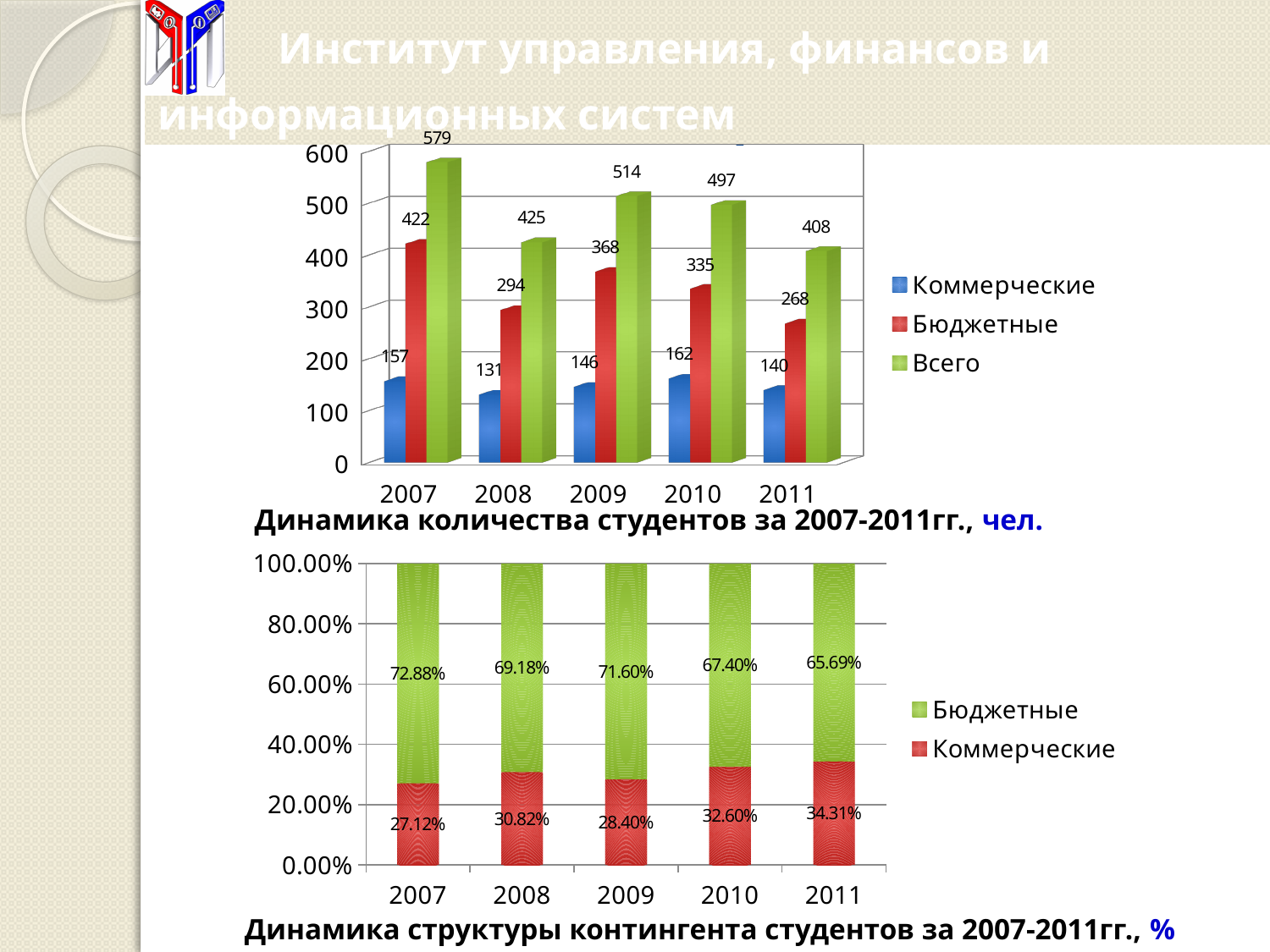
In the top chart (Динамика количества студентов за 2007-2011гг., чел.), in which year is the Всего value lowest? 2011 In the bottom chart (Динамика структуры контингента студентов за 2007-2011гг., %), in which year is the Бюджетные share highest? 2007 In the bottom chart (Динамика структуры контингента студентов за 2007-2011гг., %), what is the share of Коммерческие in 2011? 34.31% In the top chart (Динамика количества студентов за 2007-2011гг., чел.), what is the value for Всего in 2007? 579 In the top chart (Динамика количества студентов за 2007-2011гг., чел.), in which year is the Коммерческие value highest? 2010 In the top chart (Динамика количества студентов за 2007-2011гг., чел.), which is larger: Бюджетные in 2008 or Бюджетные in 2010? Бюджетные in 2010 In the top chart (Динамика количества студентов за 2007-2011гг., чел.), what is the difference between the Бюджетные values for 2007 and 2011? 154 In the bottom chart (Динамика структуры контингента студентов за 2007-2011гг., %), what is the share of Бюджетные in 2008? 69.18% In the top chart (Динамика количества студентов за 2007-2011гг., чел.), what is the value for Бюджетные in 2009? 368 What kind of chart is the bottom chart (Динамика структуры контингента студентов за 2007-2011гг., %)? Stacked bar chart In the top chart (Динамика количества студентов за 2007-2011гг., чел.), how many series does the legend list? 3 In the bottom chart (Динамика структуры контингента студентов за 2007-2011гг., %), how many years are shown on the x axis? 5